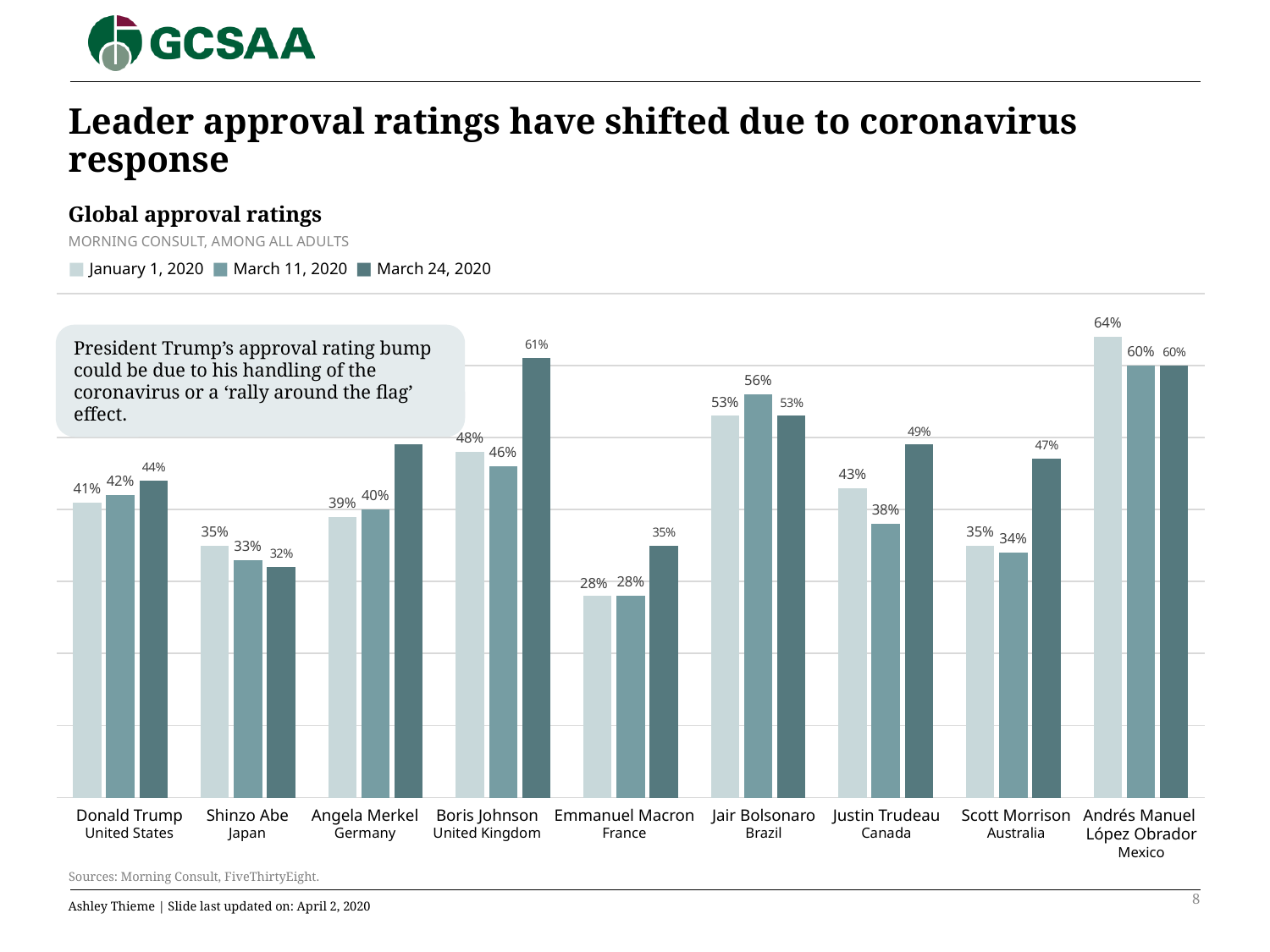
What was Boris Johnson's approval rating on January 1, 2020? 48% Who had the higher approval rating on March 24, 2020, Scott Morrison or Justin Trudeau? Justin Trudeau What was Justin Trudeau's approval rating on March 11, 2020? 38% Which leader had the highest approval rating on January 1, 2020? Andrés Manuel López Obrador How many leaders are shown in the chart? 9 Which leader had the lowest approval rating on March 11, 2020? Emmanuel Macron What is the subtitle of the chart? Global approval ratings What kind of chart is shown on the slide? Bar chart Did Shinzo Abe's approval rating rise or fall across the three dates shown? Fall By how many percentage points did Boris Johnson's approval rating change between March 11, 2020 and March 24, 2020? 15 percentage points How many series does the legend list? 3 What was Donald Trump's approval rating on March 24, 2020? 44%